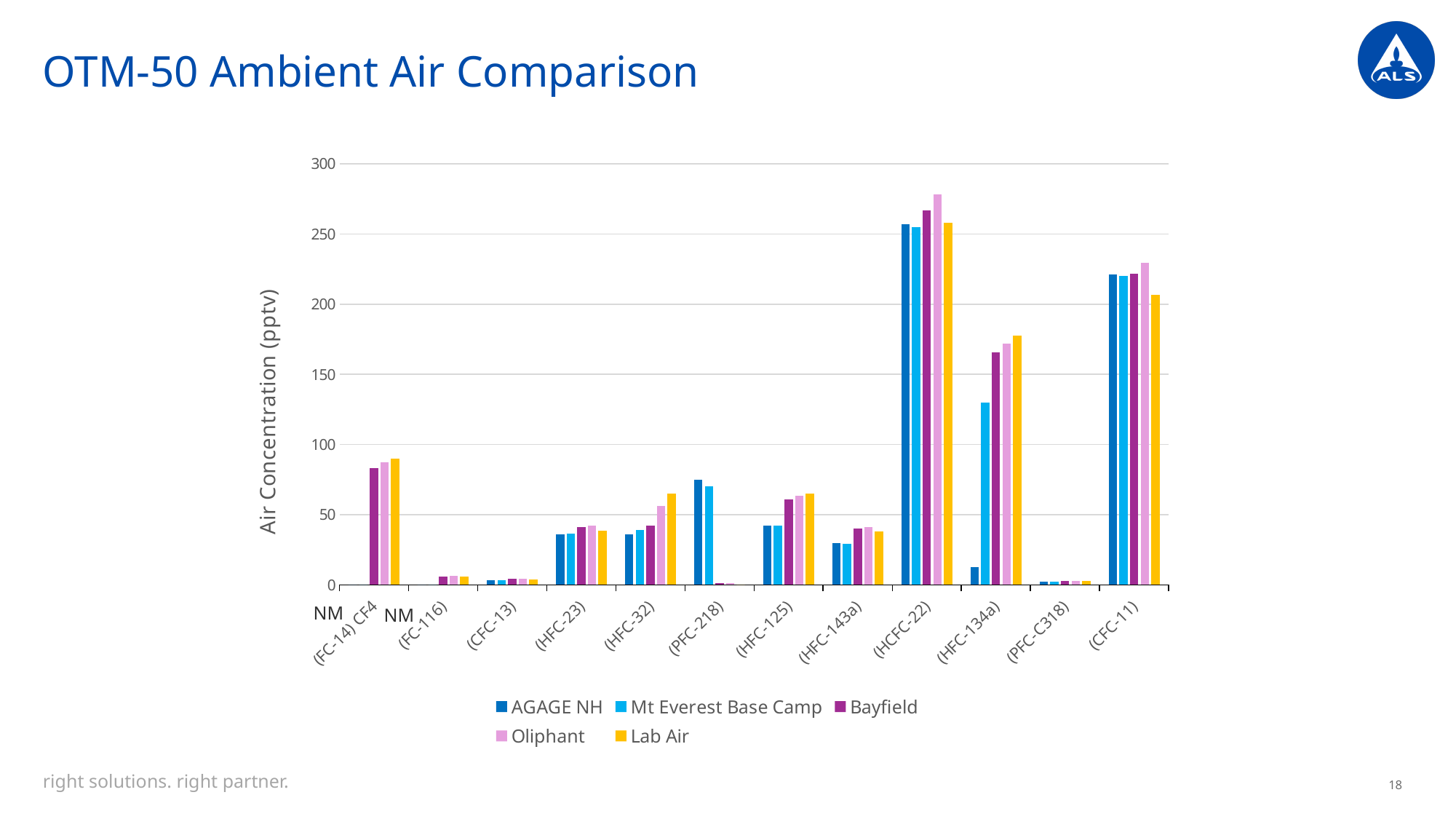
Which compound category has the highest air concentrations overall? (HCFC-22) For (HFC-134a), which is larger: the Mt Everest Base Camp value or the Bayfield value? Bayfield How many series does the legend list? 5 How many compound categories are shown along the x axis? 12 For (CFC-11), which series has the lowest value? Lab Air Which series is shown in yellow in the legend? Lab Air Is the AGAGE NH value for (HFC-134a) greater or less than 50? less For (HCFC-22), which series has the highest value? Oliphant What is the label of the vertical axis? Air Concentration (pptv) Is the Mt Everest Base Camp value for (HFC-134a) greater or less than 100? greater What kind of chart is shown on the slide? bar chart Is the Oliphant value for (HCFC-22) greater or less than 250? greater